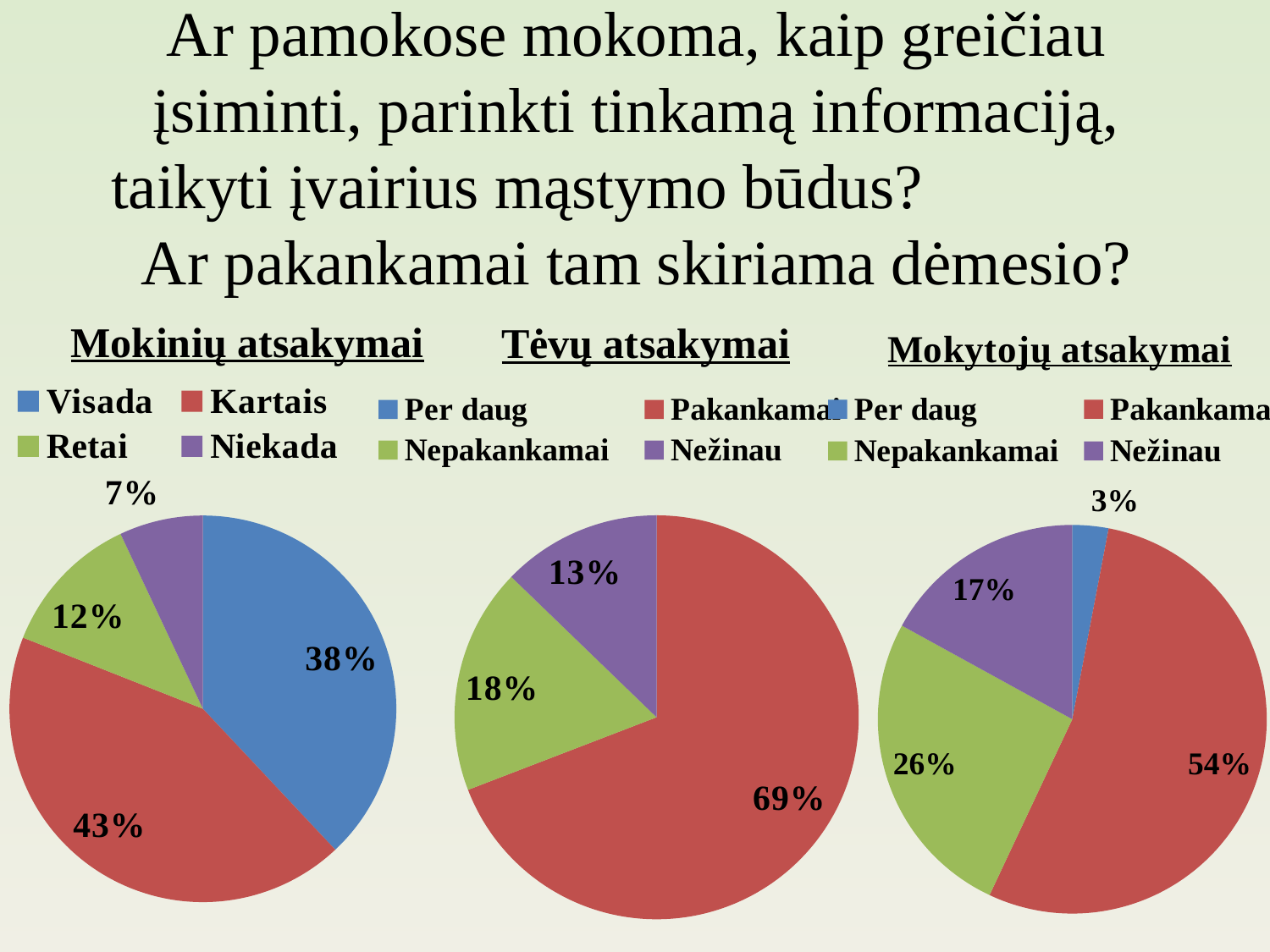
In the 'Mokytojų atsakymai' chart, which category has the smallest share? Per daug In the 'Mokinių atsakymai' chart, what is the difference between 'Visada' and 'Retai'? 26% In the 'Mokytojų atsakymai' chart, what is the difference between 'Pakankamai' and 'Nežinau'? 37% In the 'Tėvų atsakymai' chart, what percentage is shown for 'Pakankamai'? 69% In the 'Mokytojų atsakymai' chart, what percentage is shown for 'Nepakankamai'? 26% In the 'Tėvų atsakymai' chart, what is the difference between 'Nepakankamai' and 'Nežinau'? 5% How many entries does the legend of the 'Mokytojų atsakymai' chart list? 4 In the 'Tėvų atsakymai' chart, which is larger, 'Nepakankamai' or 'Nežinau'? Nepakankamai In the 'Mokinių atsakymai' chart, what percentage is shown for 'Kartais'? 43% In the 'Mokinių atsakymai' chart, what percentage is shown for 'Niekada'? 7% In the 'Mokinių atsakymai' chart, which category has the largest share? Kartais What type of chart is used for 'Mokinių atsakymai'? Pie chart